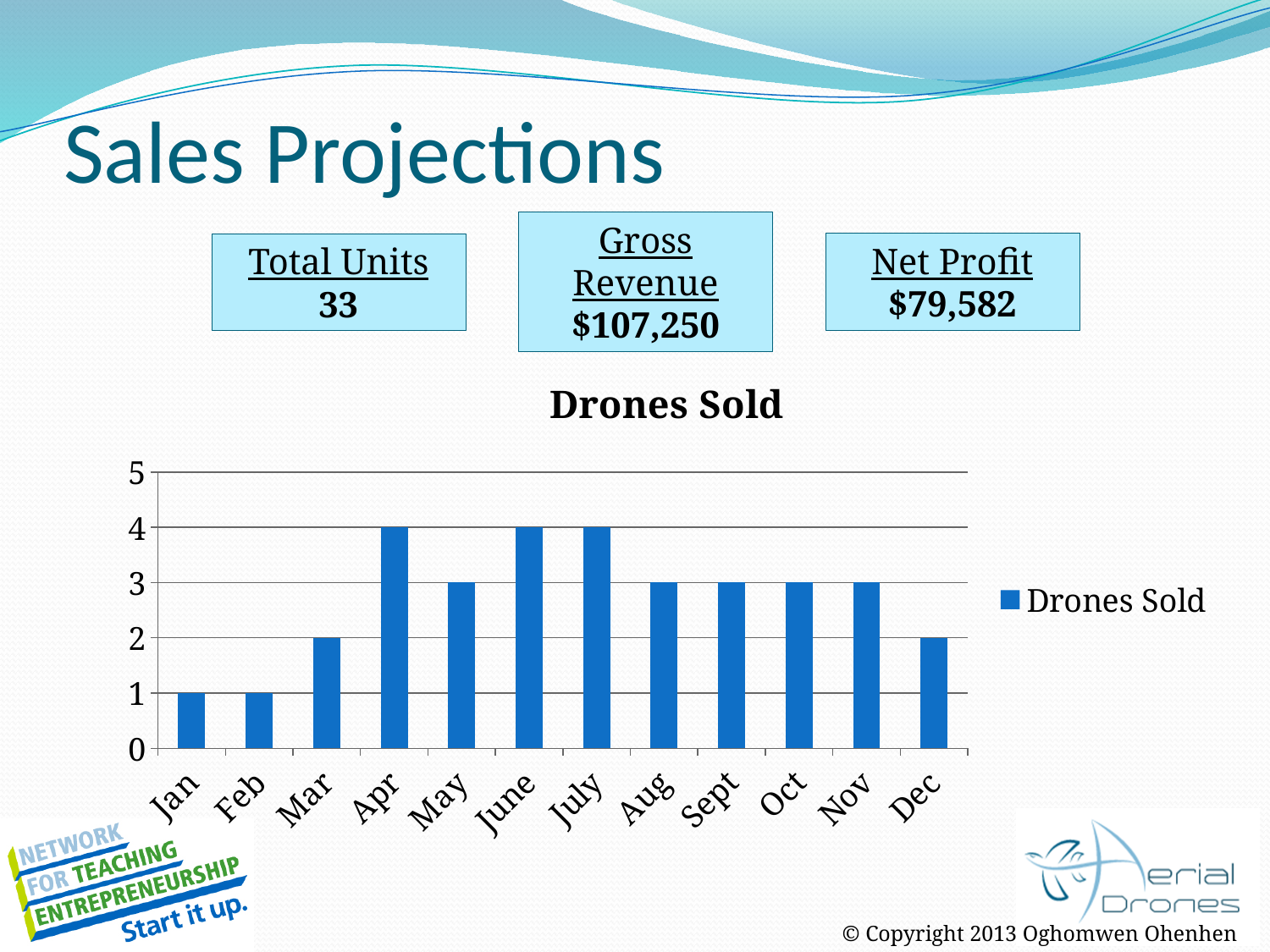
How many months are shown on the x axis of the Drones Sold chart? 12 What is the difference between drones sold in July and drones sold in Dec? 2 What type of chart is shown on the slide? bar chart Which months have the highest number of drones sold? Apr, June, July Which month has more drones sold, May or June? June How many drones are sold in Sept according to the chart? 3 How many drones are sold in Apr according to the chart? 4 How many drones are sold in Mar according to the chart? 2 What is the title of the chart? Drones Sold How many series does the legend of the Drones Sold chart list? 1 Do drones sold rise or fall from Jan to Apr? rise Which months have the lowest number of drones sold? Jan, Feb